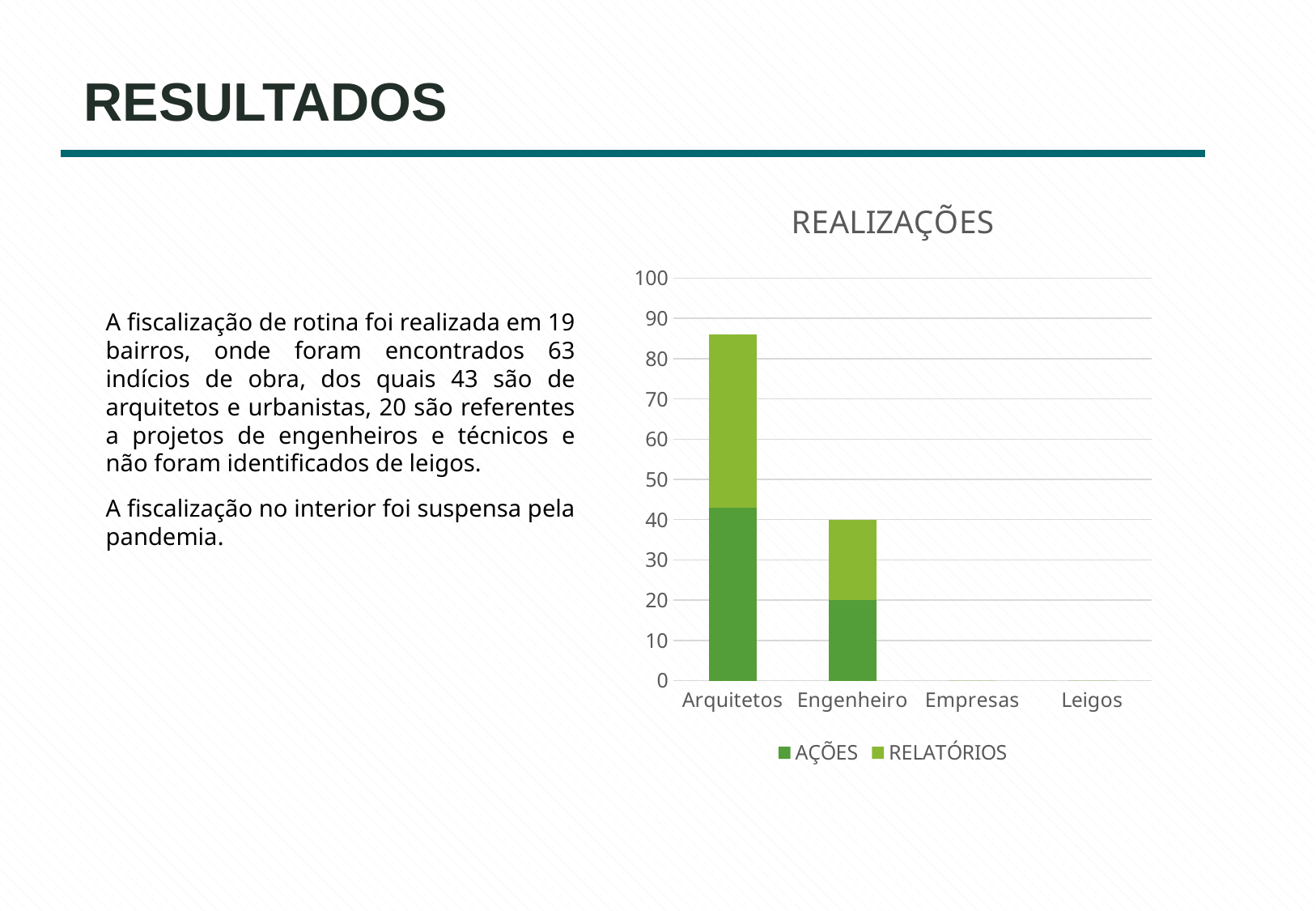
Is the AÇÕES value for Arquitetos greater or less than 40? greater Which category has the tallest stacked bar? Arquitetos What is the total height of the stacked bar for Engenheiro? 40 What kind of chart is shown on the slide? Stacked bar chart How many categories are shown on the x axis of the chart? 4 Do the stacked bar totals rise or fall from left to right along the x axis? Fall Which is larger, the stacked bar for Arquitetos or the stacked bar for Engenheiro? Arquitetos How many series does the chart legend list? 2 Which series are listed in the chart legend? AÇÕES and RELATÓRIOS Is the total stacked bar for Arquitetos greater or less than 80? greater What is the title of the chart? REALIZAÇÕES What is the AÇÕES value for Engenheiro? 20